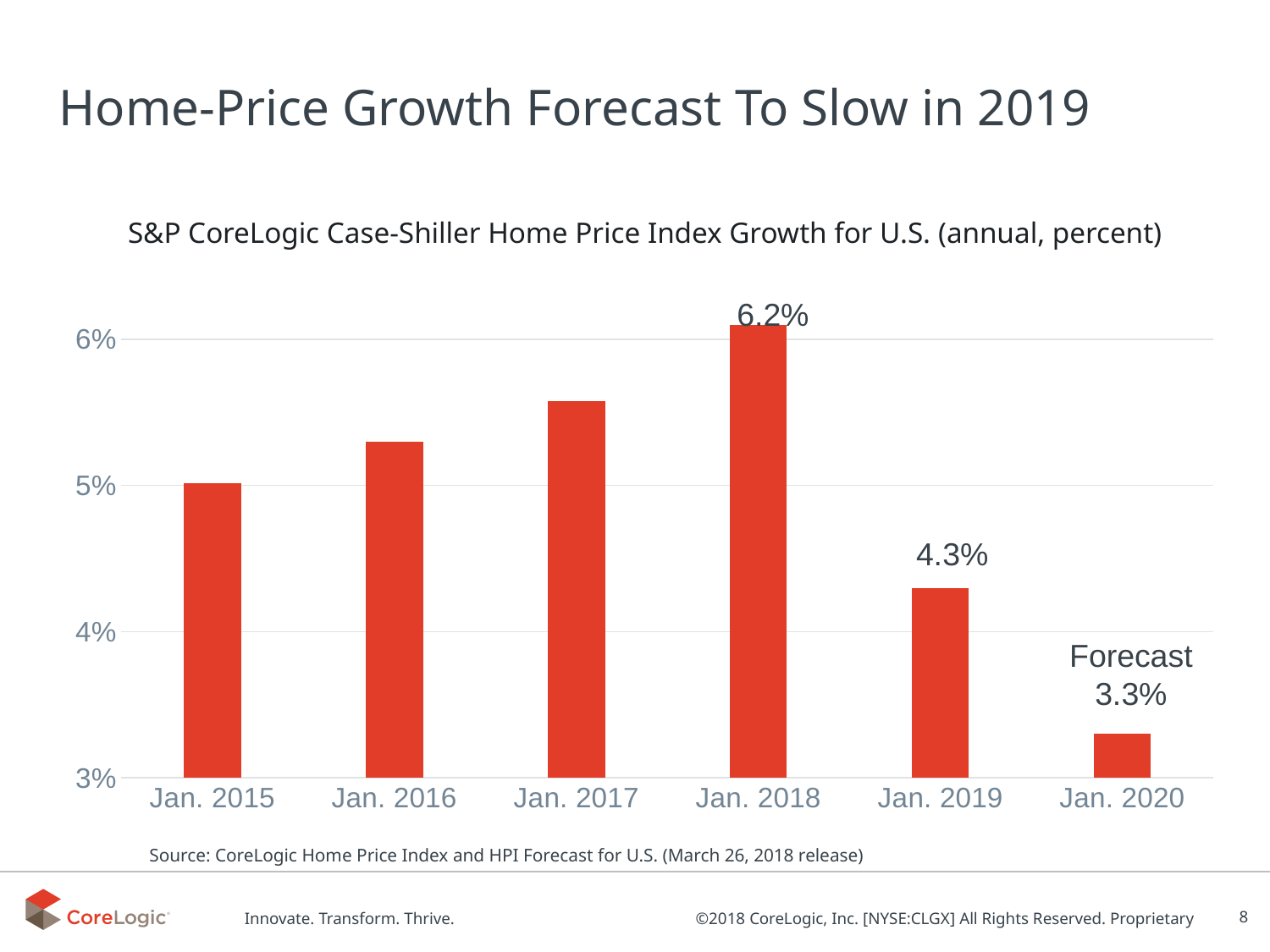
Which year has the highest home price index growth? Jan. 2018 How many bars are shown in the chart? 6 What is the value for Jan. 2019? 4.3% What type of chart is shown on the slide? Bar chart What is the forecast value for Jan. 2020? 3.3% What is the difference between the Jan. 2018 value and the Jan. 2019 value? 1.9% What is the value for Jan. 2018? 6.2% Is the value for Jan. 2017 greater or less than 6%? less Which is larger, the value for Jan. 2016 or the value for Jan. 2017? Jan. 2017 What is the difference between the Jan. 2019 value and the Jan. 2020 forecast? 1.0% Which year has the lowest home price index growth? Jan. 2020 Is the value for Jan. 2016 greater or less than 5%? greater